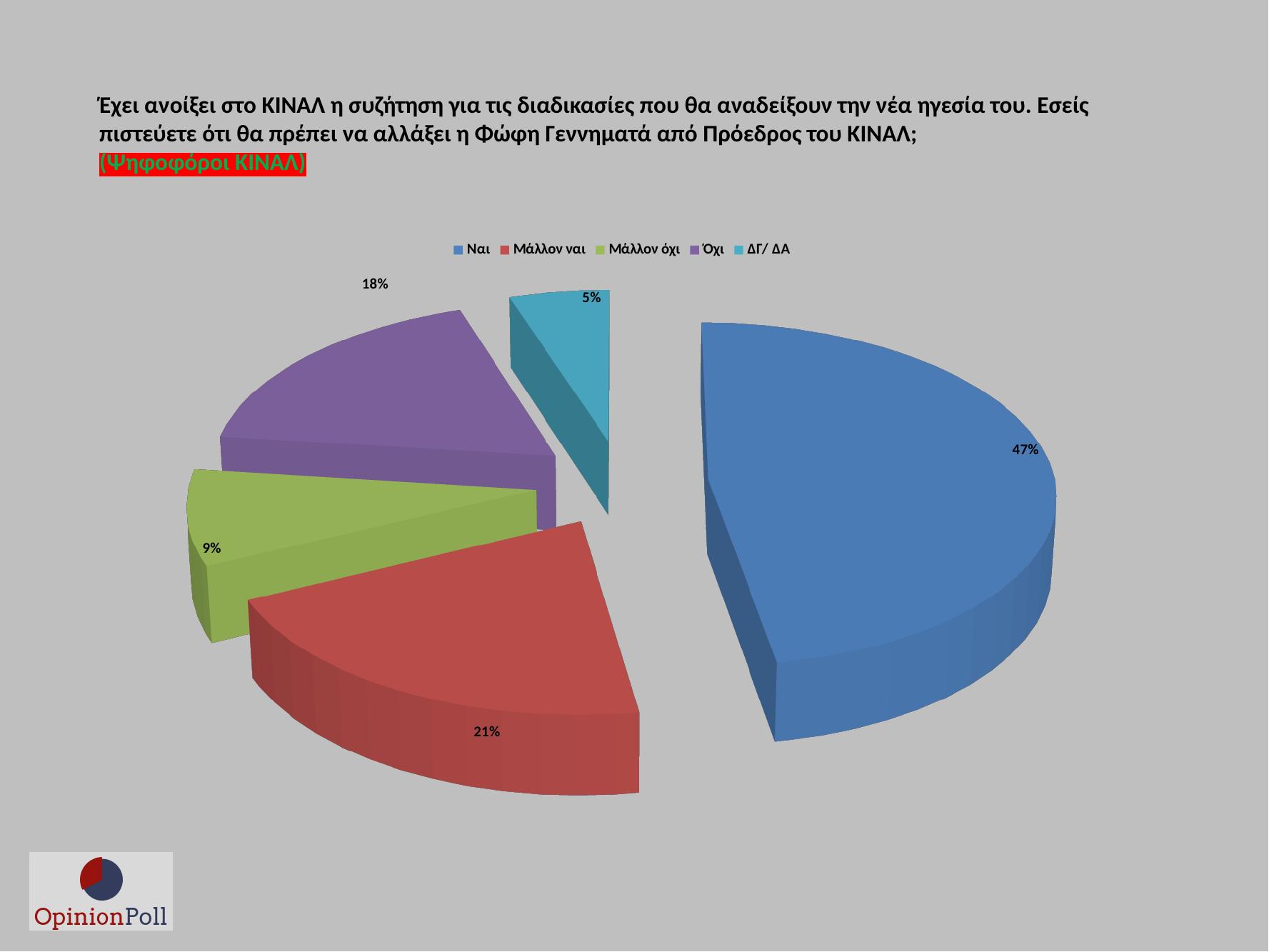
What percentage is shown for "Μάλλον ναι"? 21% What colour is the "Όχι" slice in the pie chart? Purple What percentage is shown for "Μάλλον όχι"? 9% Which category has the smallest share of the pie? ΔΓ/ ΔΑ What type of chart is shown on the slide? Pie chart How many slices does the pie chart have? 5 What percentage of the pie chart is the "Ναι" slice? 47% What percentage is shown for "ΔΓ/ ΔΑ"? 5% Which category has the largest share of the pie? Ναι What percentage is shown for "Όχι"? 18% What is the difference in percentage points between "Ναι" and "Όχι"? 29 Which is larger, the share for "Μάλλον ναι" or the share for "Όχι"? Μάλλον ναι